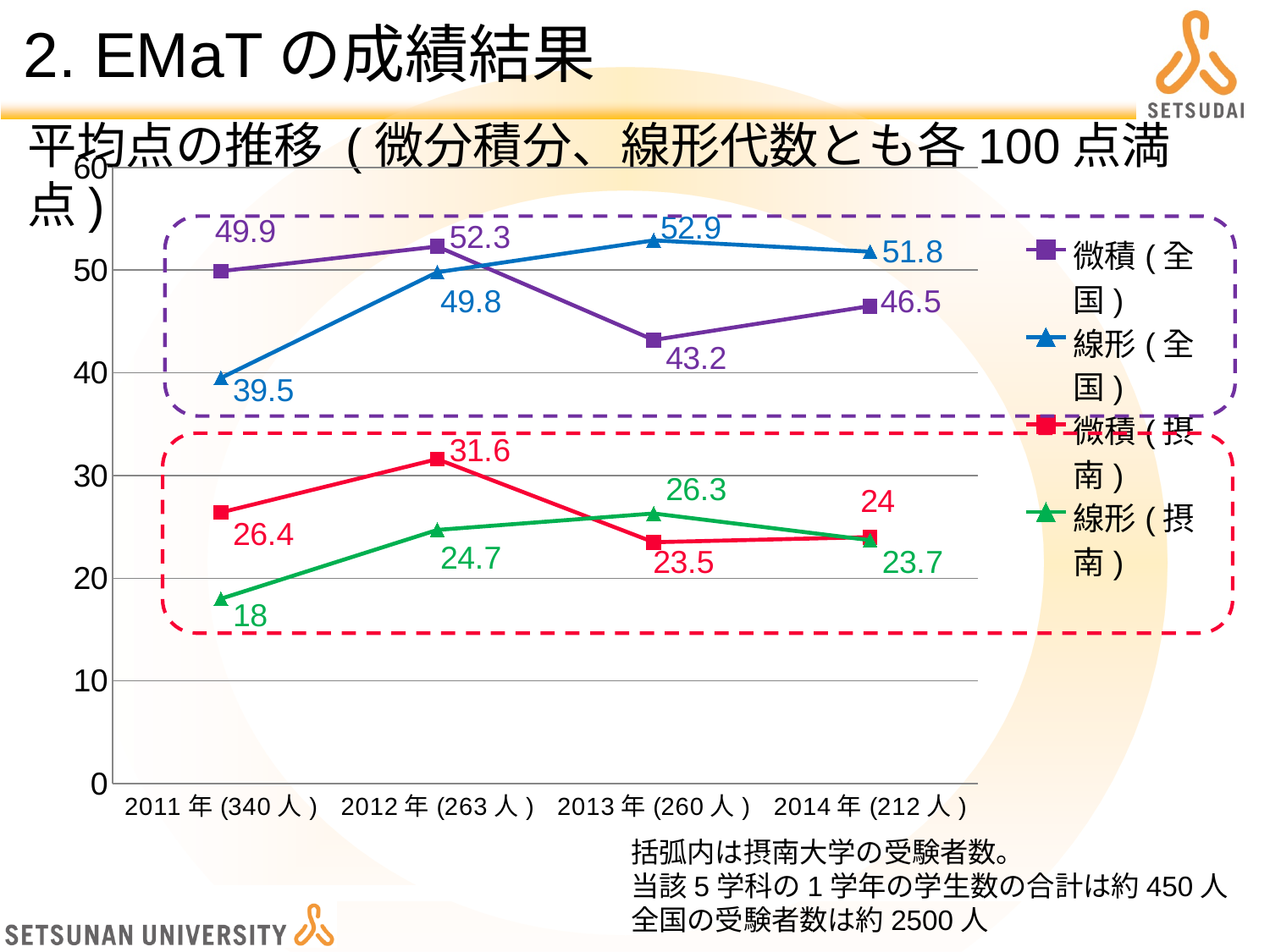
What is the value for 微積(全国) in 2011年(340人)? 49.9 What is the value for 微積(摂南) in 2012年(263人)? 31.6 How many years are shown on the x axis? 4 What kind of chart is shown on the slide? line chart What is the value for 線形(全国) in 2014年(212人)? 51.8 Does 線形(全国) rise or fall from 2011年(340人) to 2013年(260人)? rise Which is larger in 2013年(260人): 微積(全国) or 線形(全国)? 線形(全国) In which year does 線形(全国) reach its highest value? 2013年(260人) How many series does the legend list? 4 What is the difference between 微積(全国) and 微積(摂南) in 2012年(263人)? 20.7 In which year is 線形(摂南) at its lowest value? 2011年(340人) What is the value for 線形(摂南) in 2013年(260人)? 26.3